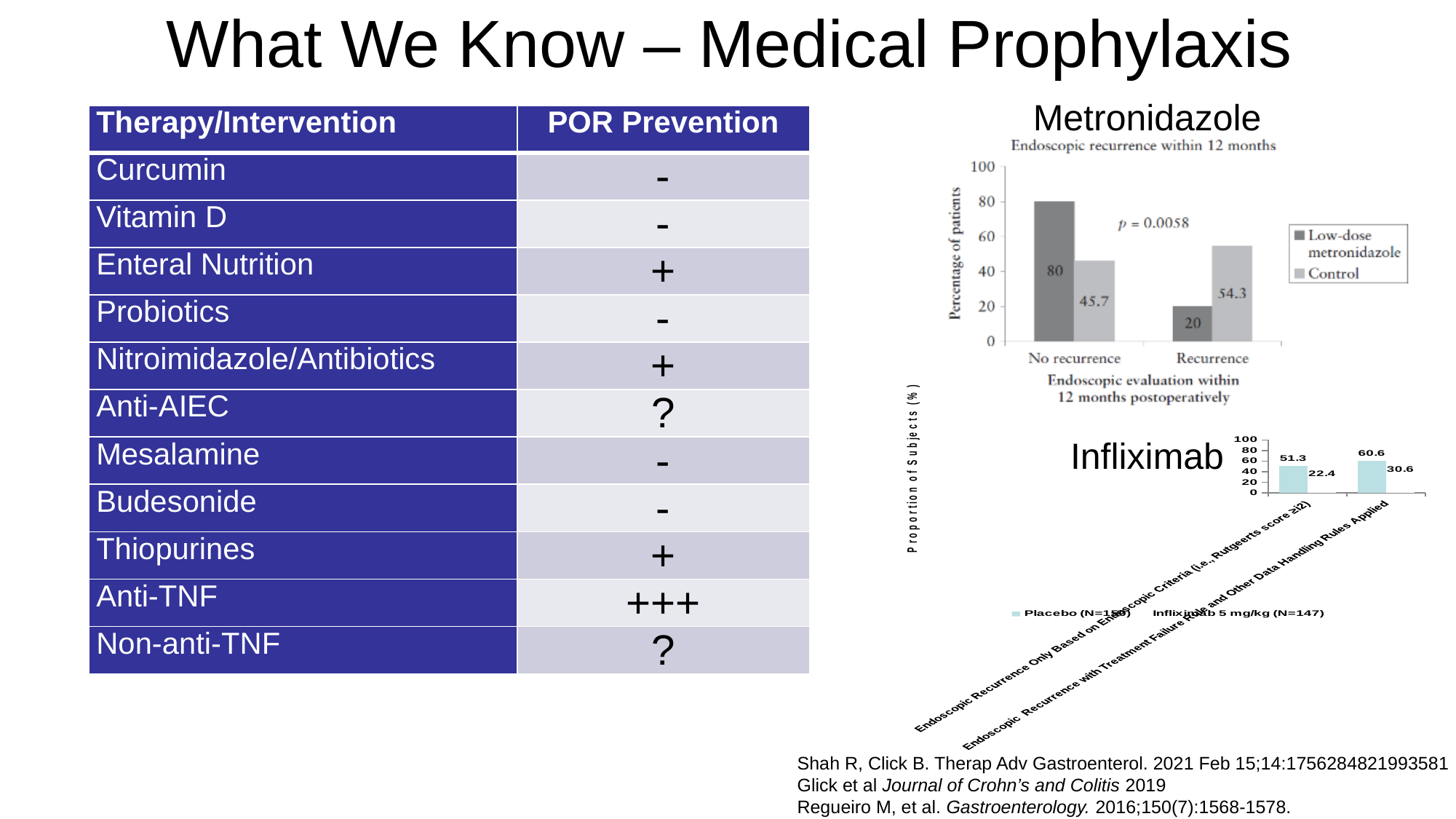
In the Metronidazole chart, what is the value for the Control group in the No recurrence category? 45.7 In the Metronidazole chart, which group has the higher value in the Recurrence category, low-dose metronidazole or Control? Control In the Infliximab chart, what is the Placebo value for the first category (Endoscopic Recurrence Only Based on Endoscopic Criteria)? 51.3 What kind of chart is the Metronidazole chart? Bar chart In the Metronidazole chart, what is the value for low-dose metronidazole in the Recurrence category? 20 In the Metronidazole chart, what is the difference between the low-dose metronidazole and Control values in the No recurrence category? 34.3 In the Metronidazole chart, what p-value is shown? p = 0.0058 In the Infliximab chart, what is the Infliximab 5 mg/kg value for the second category (Endoscopic Recurrence with Treatment Failure Rules and Other Data Handling Rules Applied)? 30.6 In the Metronidazole chart, how many series does the legend list? 2 In the Metronidazole chart, what percentage of patients in the low-dose metronidazole group had no recurrence? 80 In the Infliximab chart, what is the difference between the Placebo and Infliximab 5 mg/kg values in the second category? 30 In the Metronidazole chart, what is the value for the Control group in the Recurrence category? 54.3